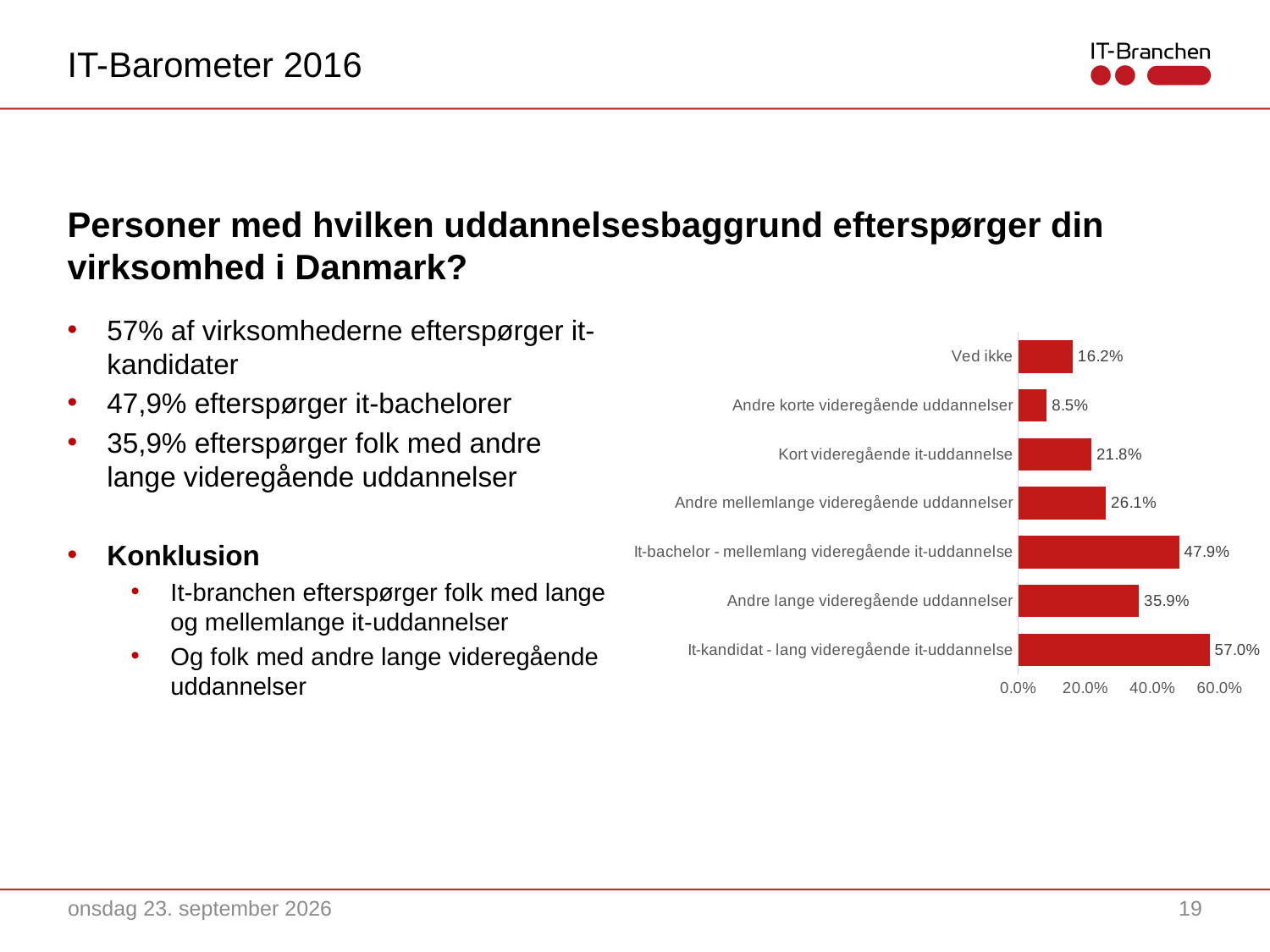
What kind of chart is shown on the slide? Bar chart What is the value for "It-kandidat - lang videregående it-uddannelse"? 57.0% What is the difference between the values for "It-kandidat - lang videregående it-uddannelse" and "It-bachelor - mellemlang videregående it-uddannelse"? 9.1% Which category has the highest value? It-kandidat - lang videregående it-uddannelse What is the highest value shown on the x axis of the chart? 60.0% Is the value for "Andre lange videregående uddannelser" greater or less than 40.0%? less Which category has the lowest value? Andre korte videregående uddannelser What is the difference between the values for "Kort videregående it-uddannelse" and "Andre korte videregående uddannelser"? 13.3% Which is larger: the value for "Kort videregående it-uddannelse" or the value for "Andre mellemlange videregående uddannelser"? Andre mellemlange videregående uddannelser What is the value for "Ved ikke"? 16.2% How many categories are shown in the chart? 7 What is the value for "Andre mellemlange videregående uddannelser"? 26.1%